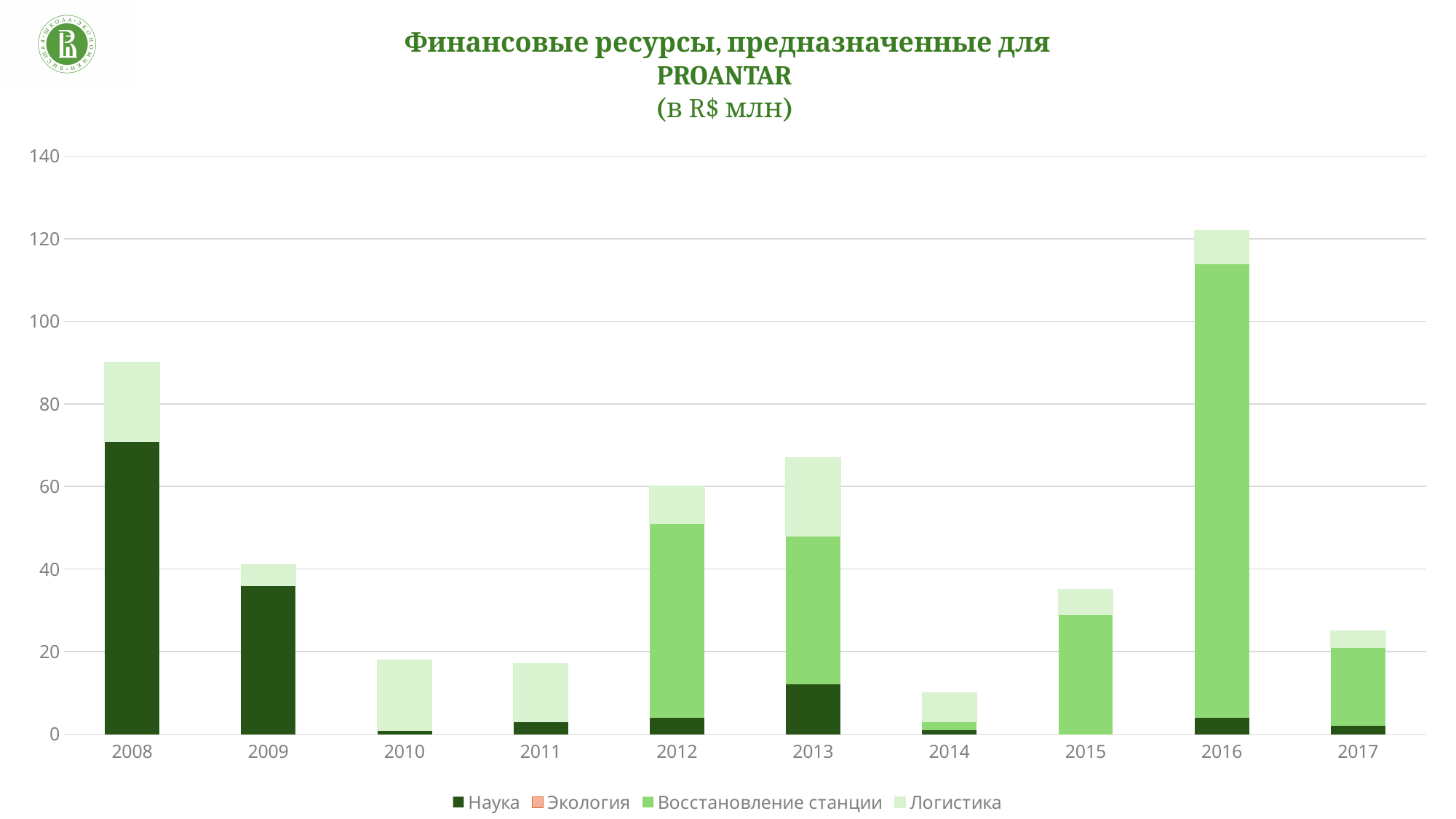
Which year has the larger total bar, 2008 or 2009? 2008 How many years are shown on the x axis of the chart? 10 Is the total value for 2008 greater or less than 80? greater Which year has the larger total bar, 2012 or 2013? 2013 Is the total value for 2015 greater or less than 40? less Is the total value for 2014 greater or less than 20? less Which year has the lowest total bar? 2014 Which year has the highest total bar? 2016 What kind of chart is shown on the slide? Stacked bar chart What unit is given in the chart title? R$ млн How many series does the legend list? 4